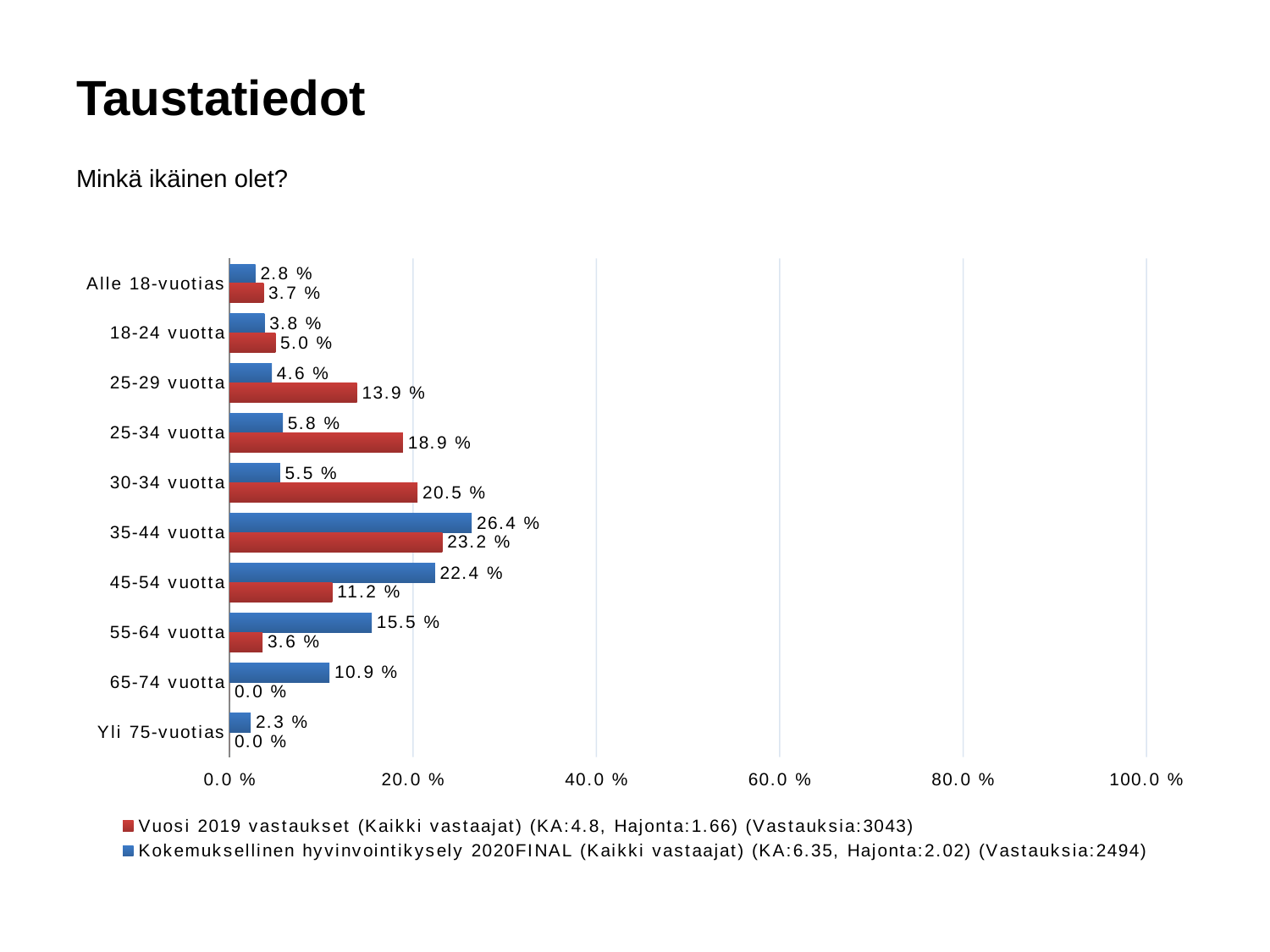
Which age category has the highest value in the Vuosi 2019 vastaukset series? 35-44 vuotta What is the value for 65-74 vuotta in the Vuosi 2019 vastaukset series? 0.0 % How many age categories are shown on the chart? 10 What is the value for 35-44 vuotta in the Kokemuksellinen hyvinvointikysely 2020FINAL series? 26.4 % What colour are the bars for the Vuosi 2019 vastaukset series? Red What type of chart is shown on the slide? Bar chart What is the value for 30-34 vuotta in the Vuosi 2019 vastaukset series? 20.5 % Which age category has the highest value in the Kokemuksellinen hyvinvointikysely 2020FINAL series? 35-44 vuotta What is the difference between the Vuosi 2019 vastaukset value and the Kokemuksellinen hyvinvointikysely 2020FINAL value for 45-54 vuotta? 11.2 % Which age category has the lowest value in the Kokemuksellinen hyvinvointikysely 2020FINAL series? Yli 75-vuotias How many series does the legend list? 2 For 55-64 vuotta, which series has the larger value: Vuosi 2019 vastaukset or Kokemuksellinen hyvinvointikysely 2020FINAL? Kokemuksellinen hyvinvointikysely 2020FINAL